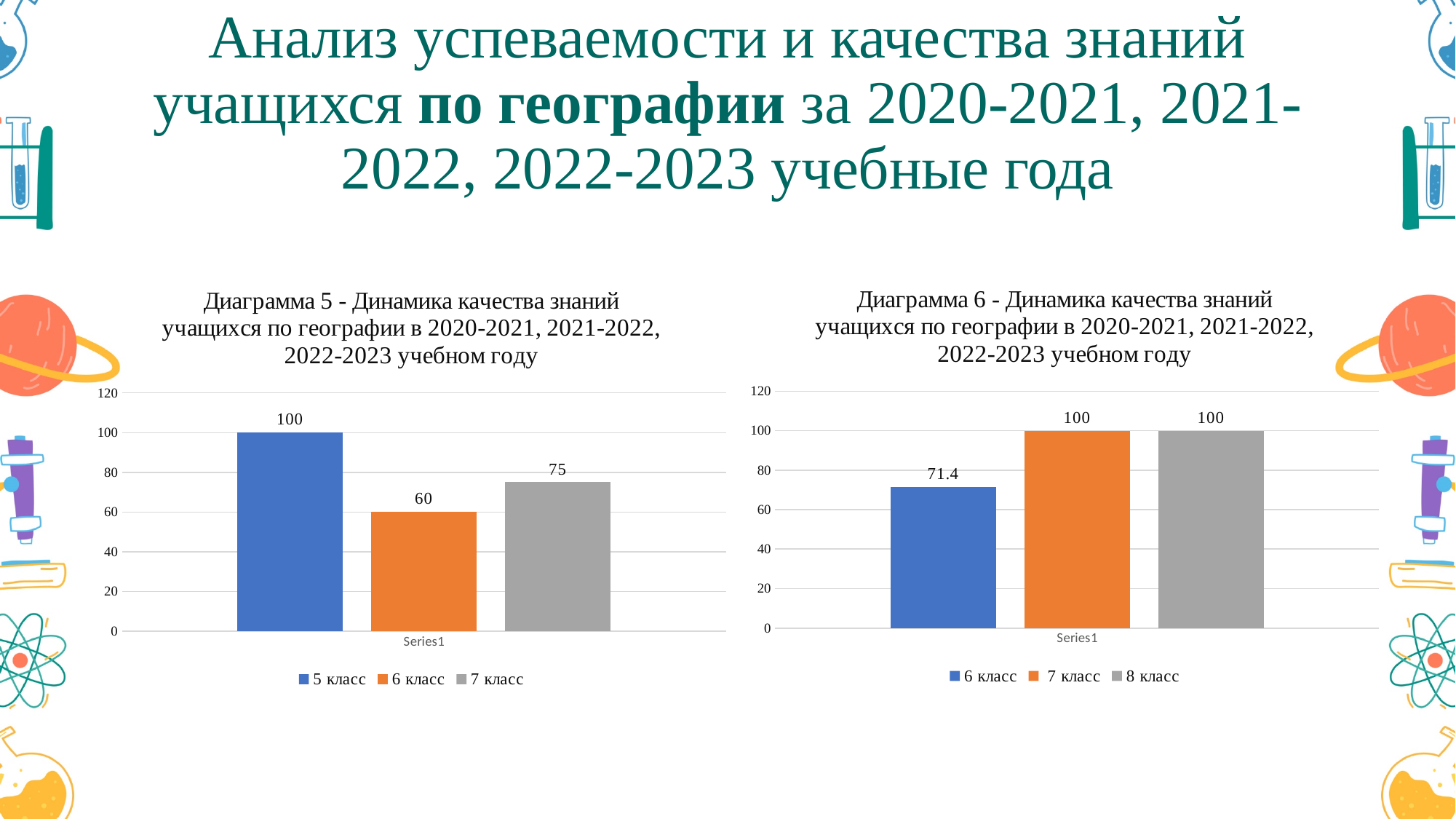
In Диаграмма 6 (right chart), what is the value for 8 класс? 100 In Диаграмма 5 (left chart), which is larger, the value for 7 класс or the value for 6 класс? 7 класс In Диаграмма 5 (left chart), what is the difference between the values for 5 класс and 6 класс? 40 How many series does the legend of Диаграмма 6 (right chart) list? 3 In Диаграмма 5 (left chart), what is the value for 7 класс? 75 What kind of chart is Диаграмма 5 (left chart)? Bar chart In Диаграмма 6 (right chart), what is the value for 6 класс? 71.4 In Диаграмма 6 (right chart), which series has the lowest value? 6 класс In Диаграмма 5 (left chart), what is the value for 5 класс? 100 In Диаграмма 5 (left chart), what is the value for 6 класс? 60 In Диаграмма 5 (left chart), which series has the lowest value? 6 класс In Диаграмма 6 (right chart), what is the difference between the values for 7 класс and 6 класс? 28.6